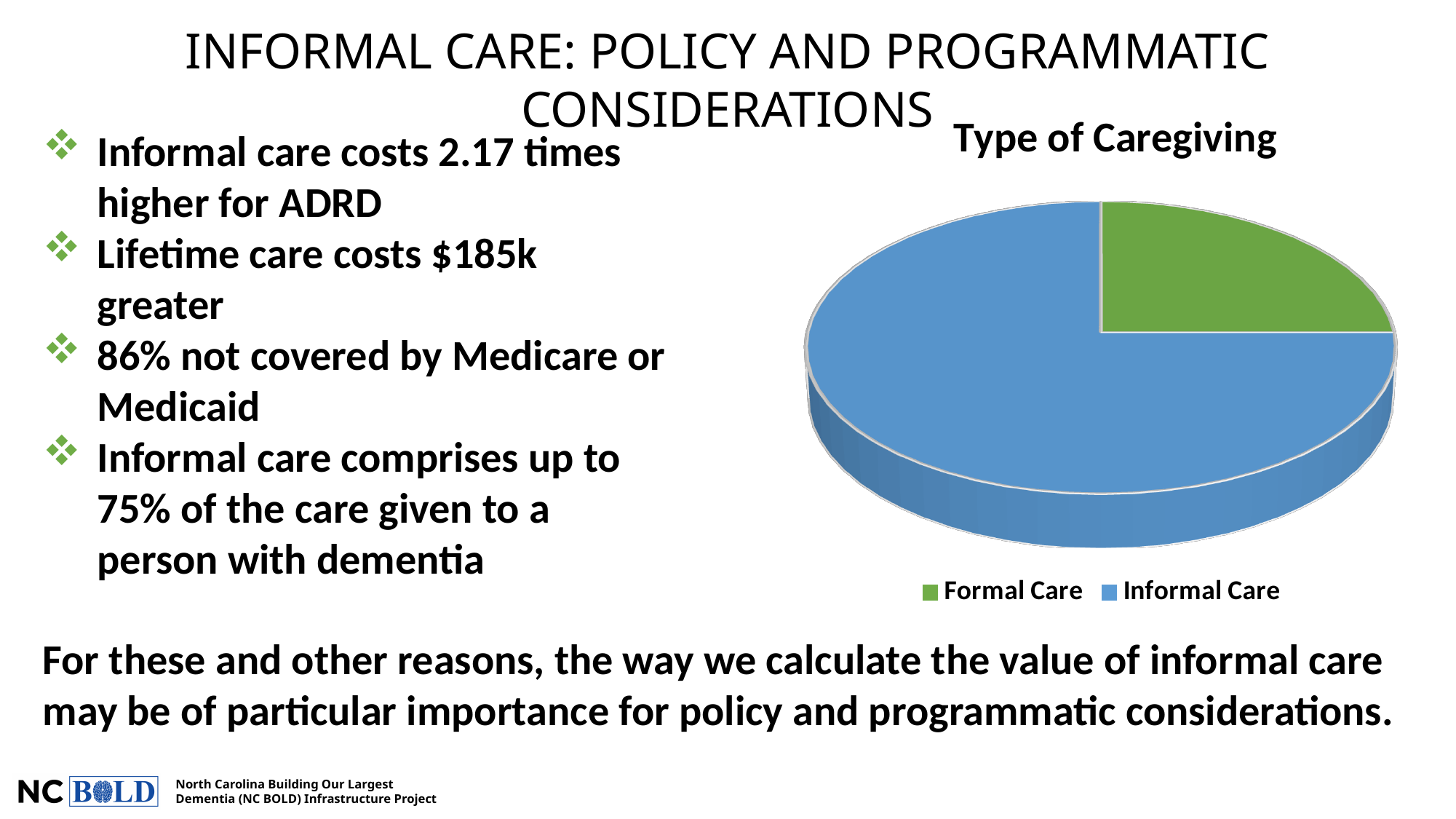
How many entries does the legend of the "Type of Caregiving" chart list? 2 Which slice of the "Type of Caregiving" pie chart is the largest? Informal Care What is the title of the chart on the slide? Type of Caregiving In the "Type of Caregiving" pie chart, which is larger: Formal Care or Informal Care? Informal Care Which category in the "Type of Caregiving" pie chart is shown in green? Formal Care What colour represents Informal Care in the "Type of Caregiving" pie chart? blue What kind of chart is shown under the title "Type of Caregiving"? pie chart Which slice of the "Type of Caregiving" pie chart is the smallest? Formal Care How many slices does the "Type of Caregiving" pie chart have? 2